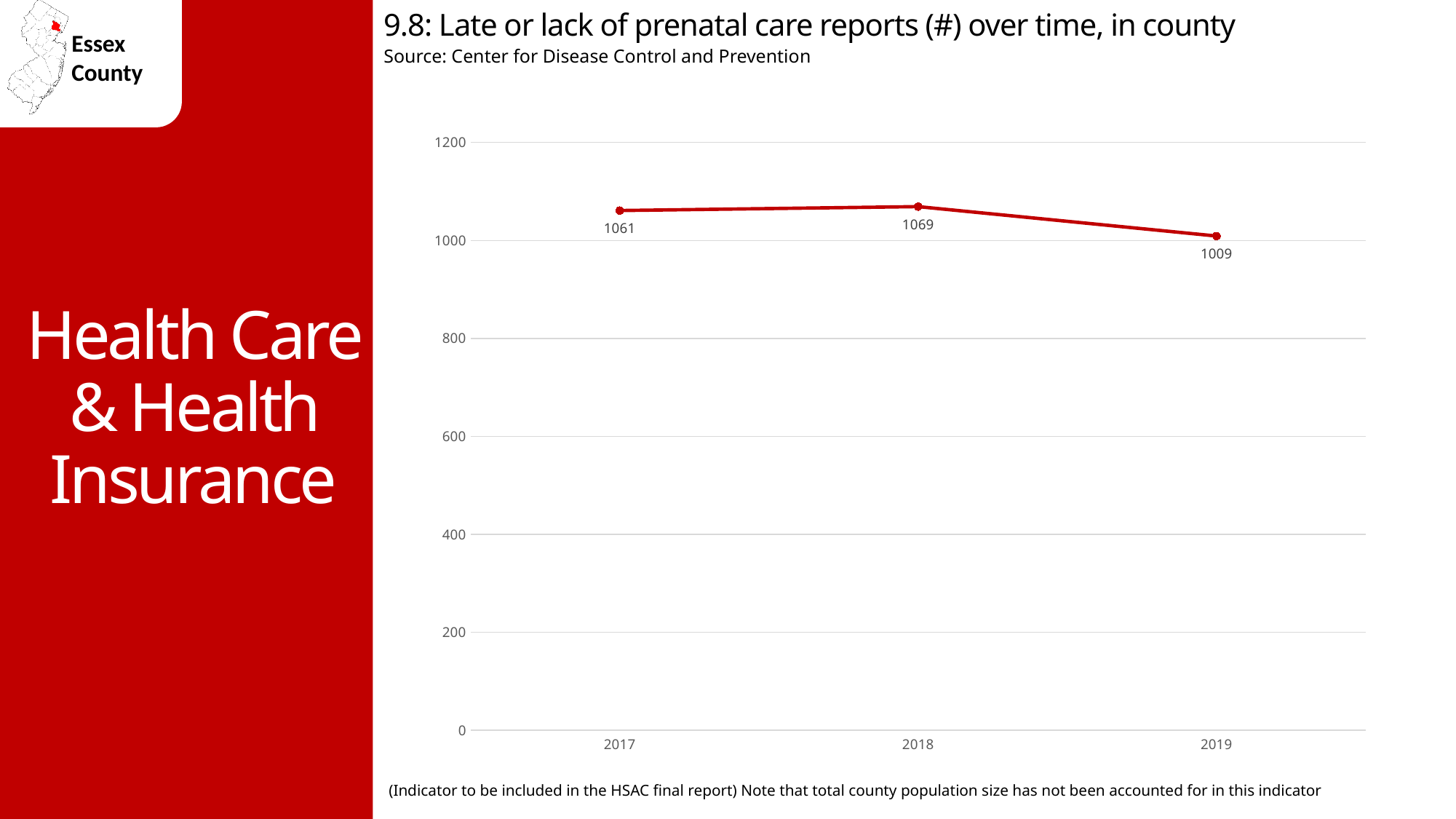
What kind of chart is shown on the slide? line chart Which year has the lowest number of late or lack of prenatal care reports? 2019 Is the value for 2019 greater or less than 1200? less What is the number of late or lack of prenatal care reports in 2019? 1009 What is the number of late or lack of prenatal care reports in 2018? 1069 What is the number of late or lack of prenatal care reports in 2017? 1061 Which year has the highest number of late or lack of prenatal care reports? 2018 What is the source of the data shown in the chart? Center for Disease Control and Prevention What is the difference between the 2017 and 2018 values? 8 Which year has a larger value, 2017 or 2019? 2017 What is the difference between the 2018 and 2019 values? 60 How many years are plotted on the chart? 3